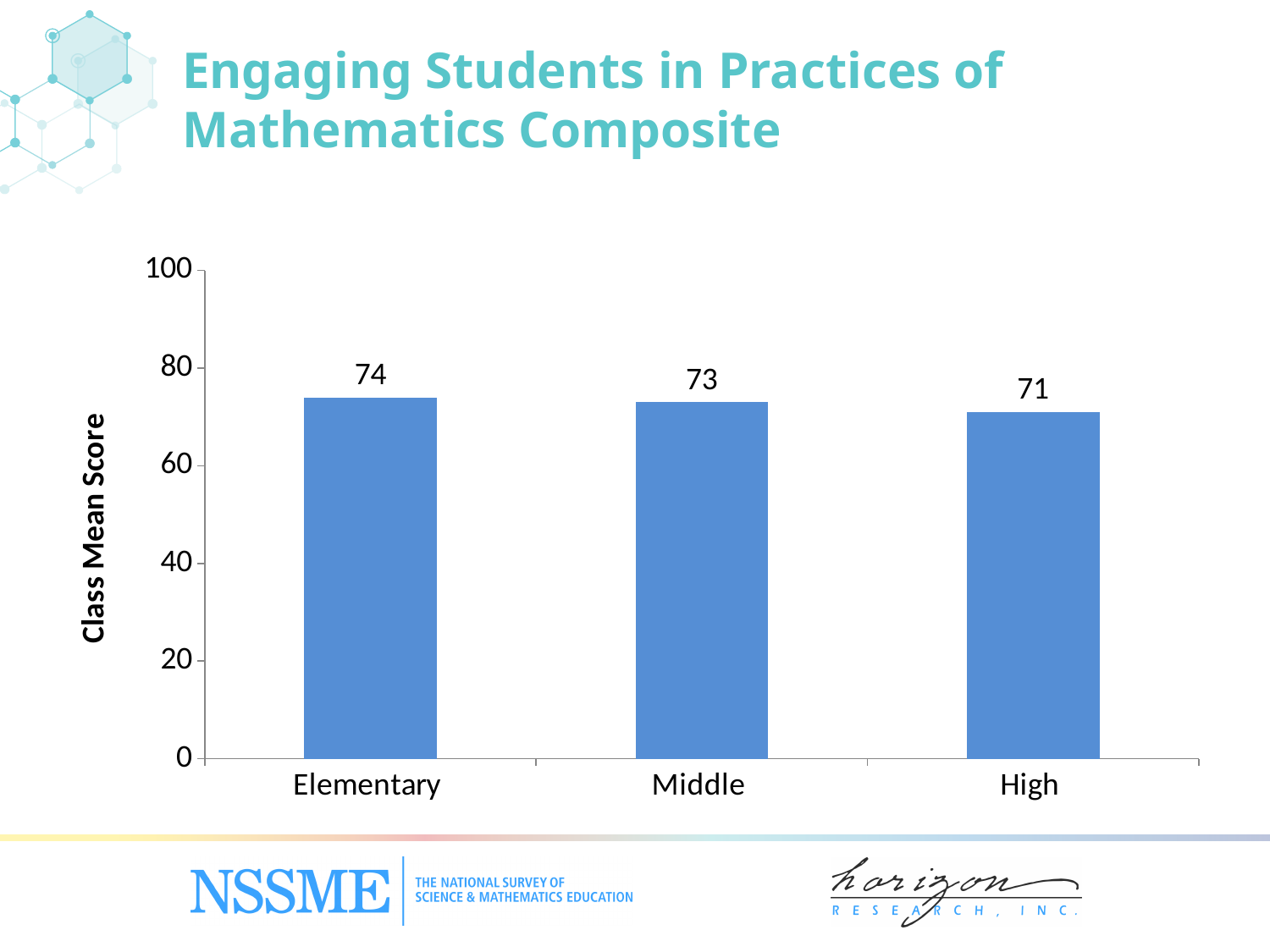
What is the label on the vertical axis of the chart? Class Mean Score What is the class mean score for Elementary? 74 Which grade level has the lowest class mean score? High What is the difference between the class mean scores for Middle and High? 2 Do the class mean scores rise or fall from Elementary to High? fall Which grade level has the highest class mean score? Elementary What kind of chart is shown on the slide? bar chart What is the class mean score for High? 71 Is the class mean score for High greater or less than 80? less What is the class mean score for Middle? 73 What is the difference between the class mean scores for Elementary and High? 3 How many grade-level categories are shown on the chart? 3